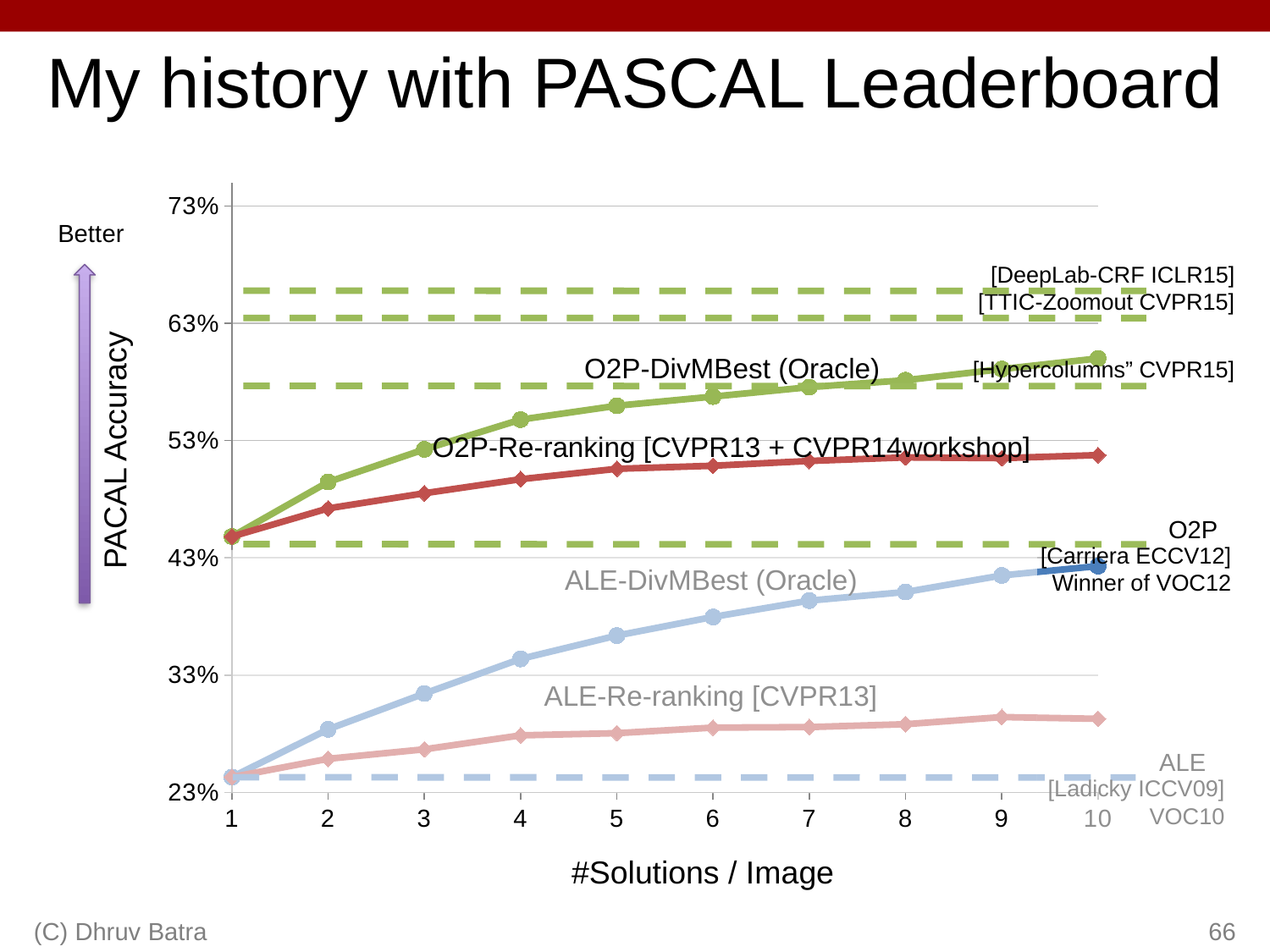
What kind of chart is shown on the slide? line chart Which solid line has the lowest accuracy at 10 solutions per image? ALE-Re-ranking [CVPR13] Is the value of O2P-DivMBest (Oracle) at 10 solutions per image greater or less than 53%? greater At 10 solutions per image, which is larger: O2P-Re-ranking or ALE-DivMBest (Oracle)? O2P-Re-ranking Is the dashed DeepLab-CRF ICLR15 line above or below 63%? above Is the value of O2P-Re-ranking at 10 solutions per image greater or less than 43%? greater What is the title of the x axis? #Solutions / Image Which solid line reaches the highest accuracy at 10 solutions per image? O2P-DivMBest (Oracle) How many points along the x axis (#Solutions / Image) does each line span? 10 Does the O2P-DivMBest (Oracle) line rise or fall as #Solutions / Image increases? rise